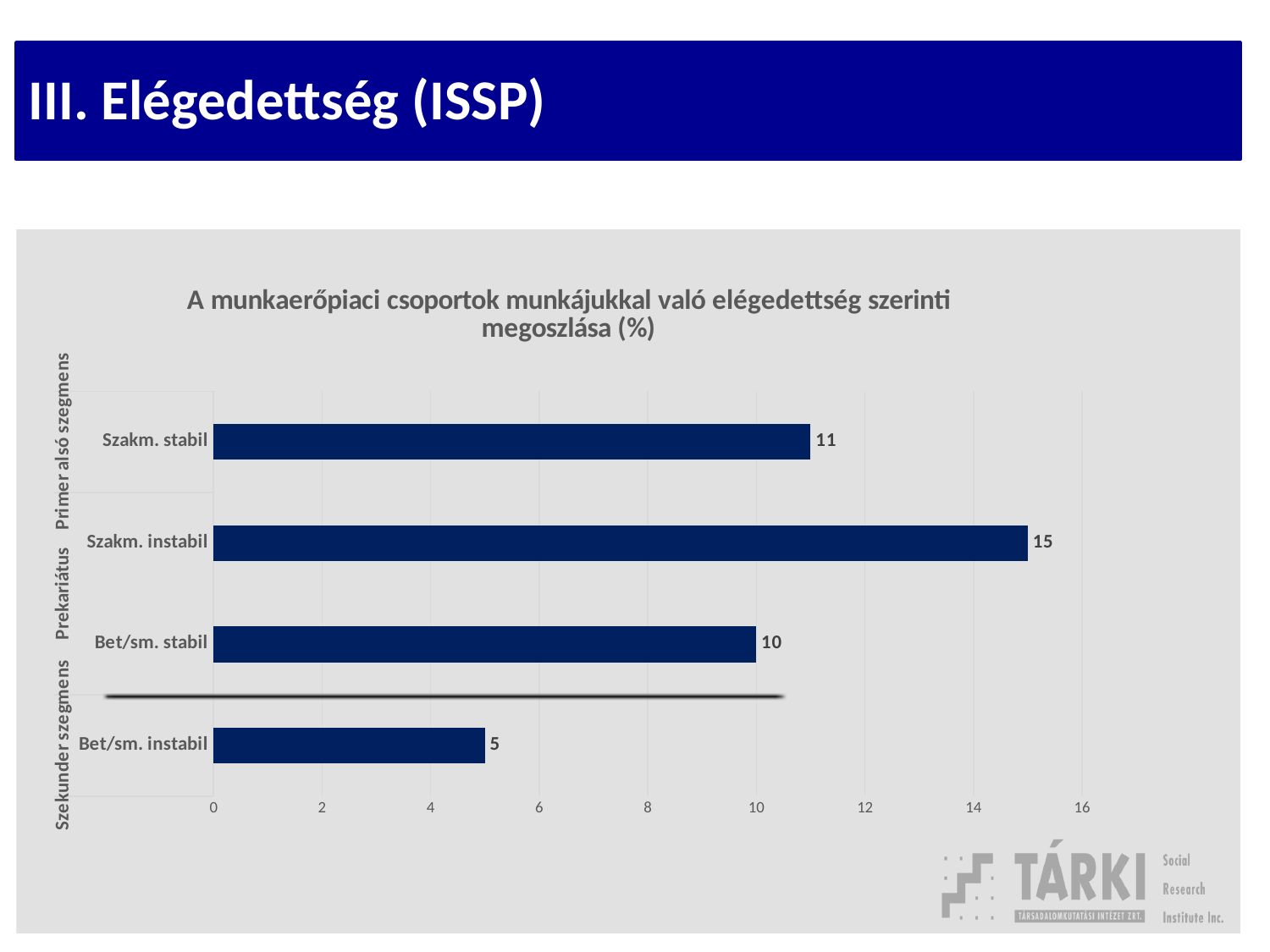
How many categories are shown in the chart? 4 Which is larger, the value for Szakm. stabil or the value for Bet/sm. stabil? Szakm. stabil What kind of chart is shown on the slide? bar chart Which category has the lowest value? Bet/sm. instabil What is the value for Szakm. stabil? 11 What is the value for Bet/sm. instabil? 5 Which category has the highest value? Szakm. instabil What is the value for Szakm. instabil? 15 What is the title of the chart? A munkaerőpiaci csoportok munkájukkal való elégedettség szerinti megoszlása (%) What is the difference between the values for Szakm. instabil and Bet/sm. instabil? 10 Is the value for Szakm. instabil greater or less than 14? greater What is the value for Bet/sm. stabil? 10